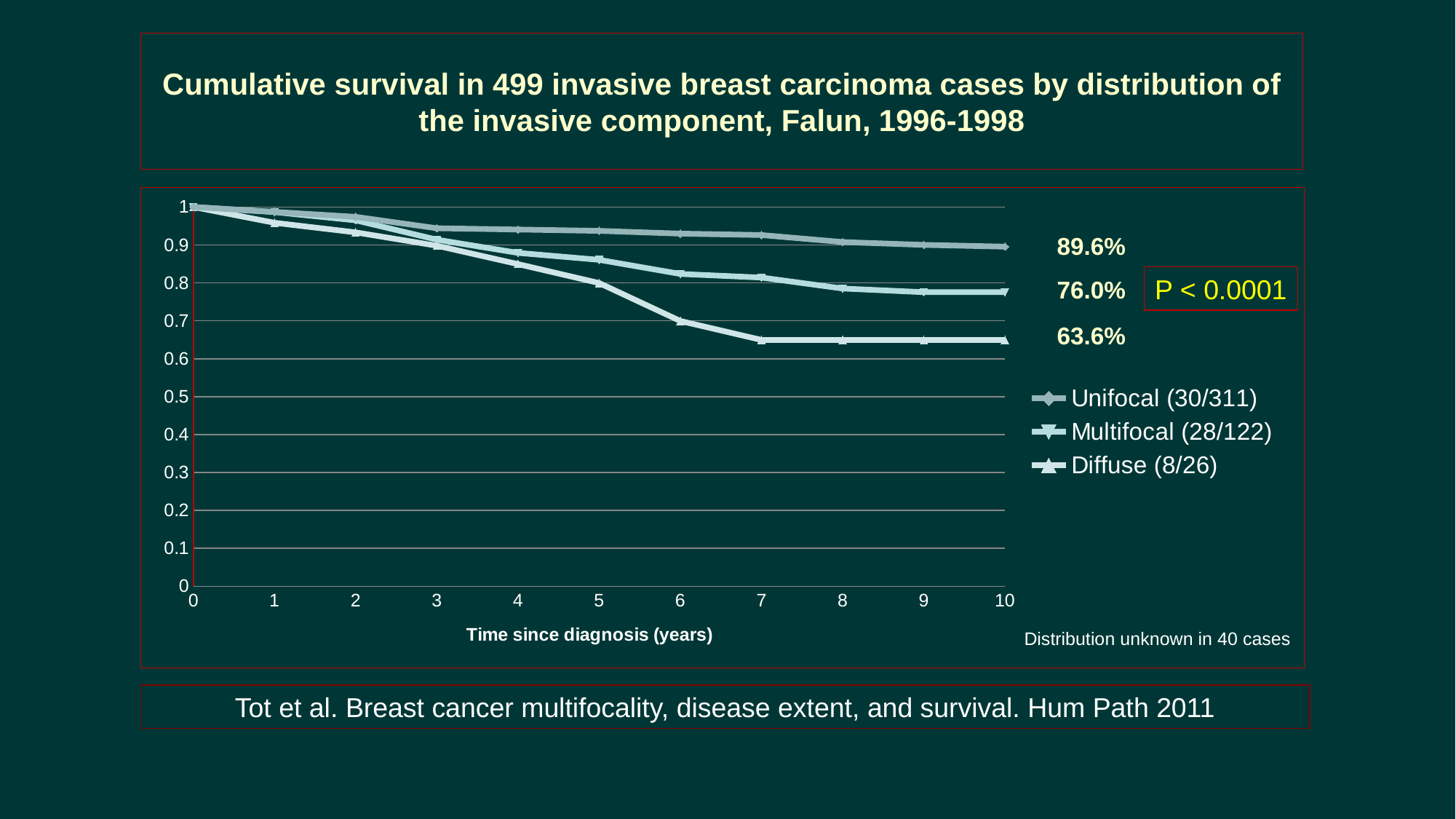
Do the survival curves rise or fall as time since diagnosis increases? Fall What is the cumulative survival labelled at the end of the Multifocal (28/122) line? 76.0% What is the title of the x axis? Time since diagnosis (years) Which group has the lowest cumulative survival at 10 years? Diffuse (8/26) What is the cumulative survival labelled at the end of the Diffuse (8/26) line? 63.6% Is the value for the Diffuse (8/26) line at 7 years greater or less than 0.7? less Is the value for the Unifocal (30/311) line at 5 years greater or less than 0.9? greater Which group has the highest cumulative survival at 10 years? Unifocal (30/311) What is the cumulative survival labelled at the end of the Unifocal (30/311) line? 89.6% How many series does the legend list? 3 What kind of chart is shown on the slide? Line chart What is the difference between the final survival values of the Unifocal and Diffuse groups? 26.0 percentage points